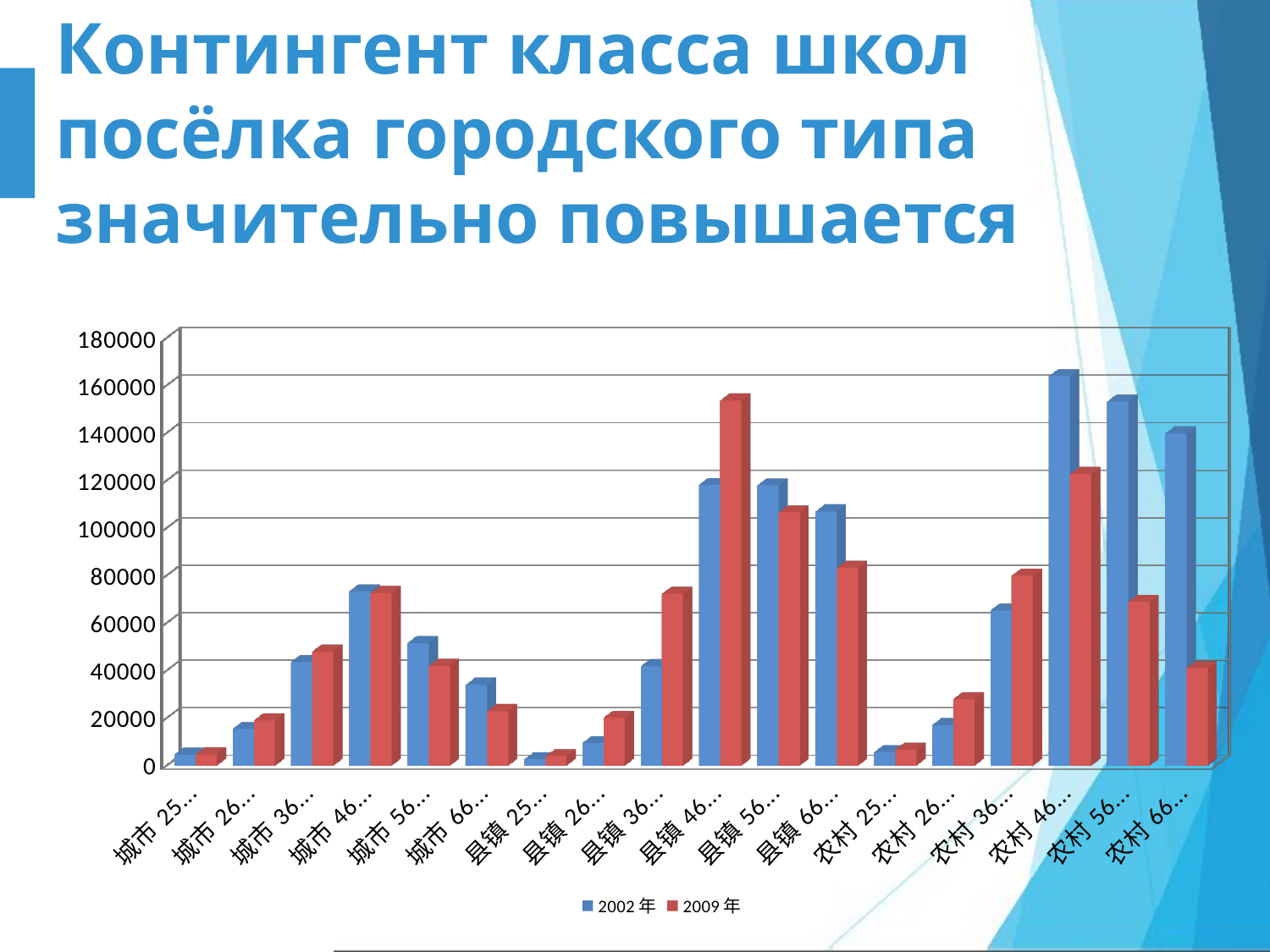
Which colour represents the 2009年 series in the legend? red Is the 2009年 value for 县镇 46... greater or less than 140000? greater What kind of chart is shown on the slide? bar chart How many categories are shown along the x axis? 18 How many series does the legend list? 2 Is the 2009年 value for 城市 66... greater or less than 40000? less Is the 2002年 value for 农村 46... greater or less than 140000? greater For 农村 46..., which series has the larger value, 2002年 or 2009年? 2002年 For 县镇 36..., which series has the larger value, 2002年 or 2009年? 2009年 Which category has the highest 2009年 value? 县镇 46... Which category has the highest 2002年 value? 农村 46...